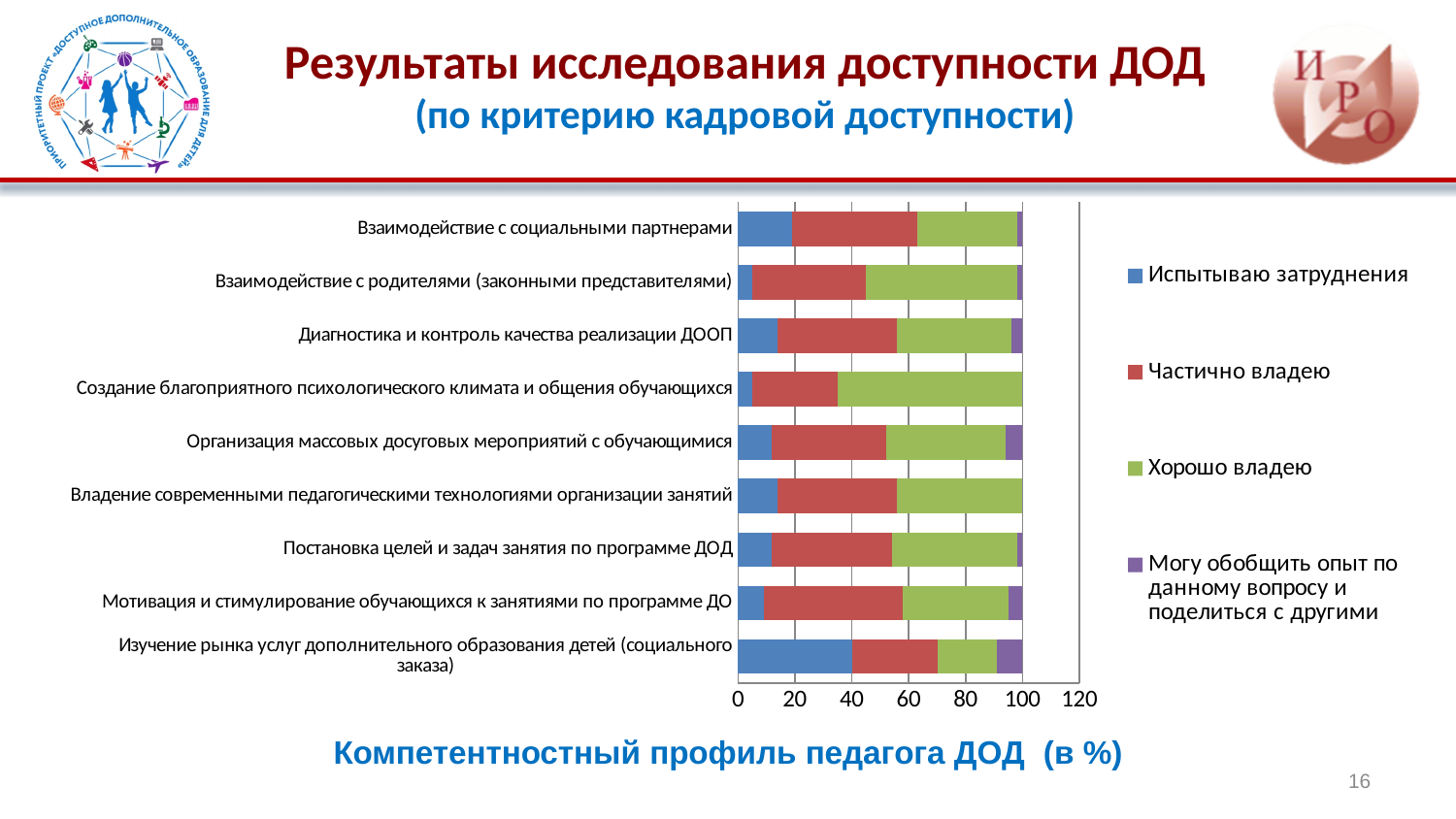
What kind of chart is shown on the slide? Stacked horizontal bar chart Which has the larger 'Испытываю затруднения' segment: 'Изучение рынка услуг дополнительного образования детей (социального заказа)' or 'Взаимодействие с родителями (законными представителями)'? Изучение рынка услуг дополнительного образования детей (социального заказа) How many series does the legend list? 4 Which colour represents the series 'Хорошо владею' in the legend? Green Which category has the largest 'Испытываю затруднения' (blue) segment? Изучение рынка услуг дополнительного образования детей (социального заказа) What is the caption printed below the chart? Компетентностный профиль педагога ДОД (в %) Which category has the smallest 'Хорошо владею' (green) segment? Изучение рынка услуг дополнительного образования детей (социального заказа) Is the 'Испытываю затруднения' value for 'Взаимодействие с родителями (законными представителями)' greater or less than 20? less Which category has the largest 'Хорошо владею' (green) segment? Создание благоприятного психологического климата и общения обучающихся Is the total length of the bar for 'Взаимодействие с социальными партнерами' greater or less than 120? less How many categories (bars) does the chart show? 9 Is the 'Испытываю затруднения' value for 'Изучение рынка услуг дополнительного образования детей (социального заказа)' greater or less than 20? greater